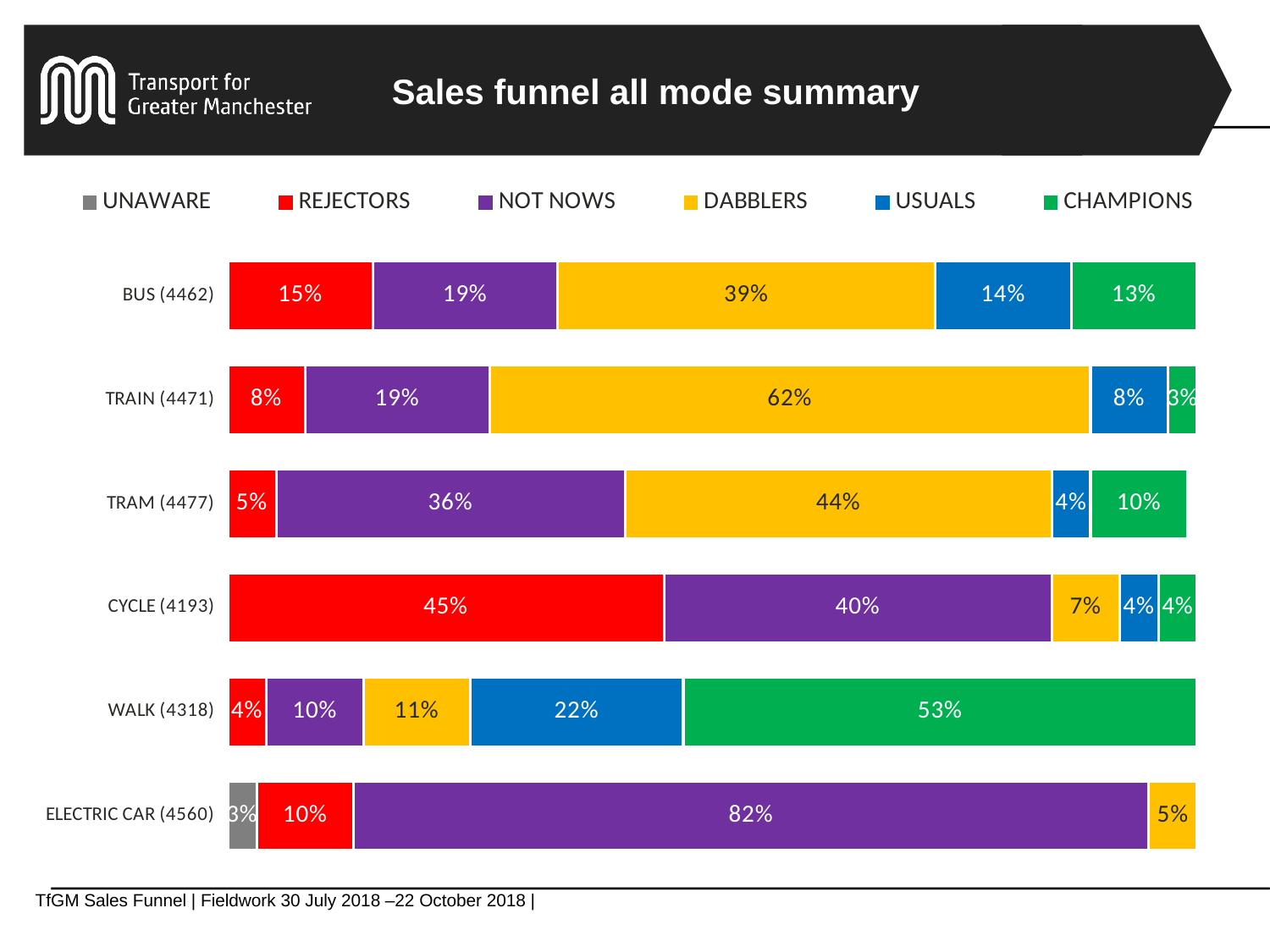
What kind of chart is shown on the slide? stacked bar chart Which is larger: the USUALS percentage for BUS (4462) or for WALK (4318)? WALK (4318) What is the DABBLERS percentage for TRAIN (4471)? 62% What is the REJECTORS percentage for CYCLE (4193)? 45% How many series does the legend list? 6 What is the CHAMPIONS percentage for WALK (4318)? 53% What is the difference between the DABBLERS percentage for TRAIN (4471) and for BUS (4462)? 23% What is the NOT NOWS percentage for ELECTRIC CAR (4560)? 82% How many transport modes (categories) are shown in the chart? 6 Which transport mode is the only one with an UNAWARE segment labelled in the chart? ELECTRIC CAR (4560) Which transport mode has the lowest REJECTORS percentage? WALK (4318) Which transport mode has the highest CHAMPIONS percentage? WALK (4318)